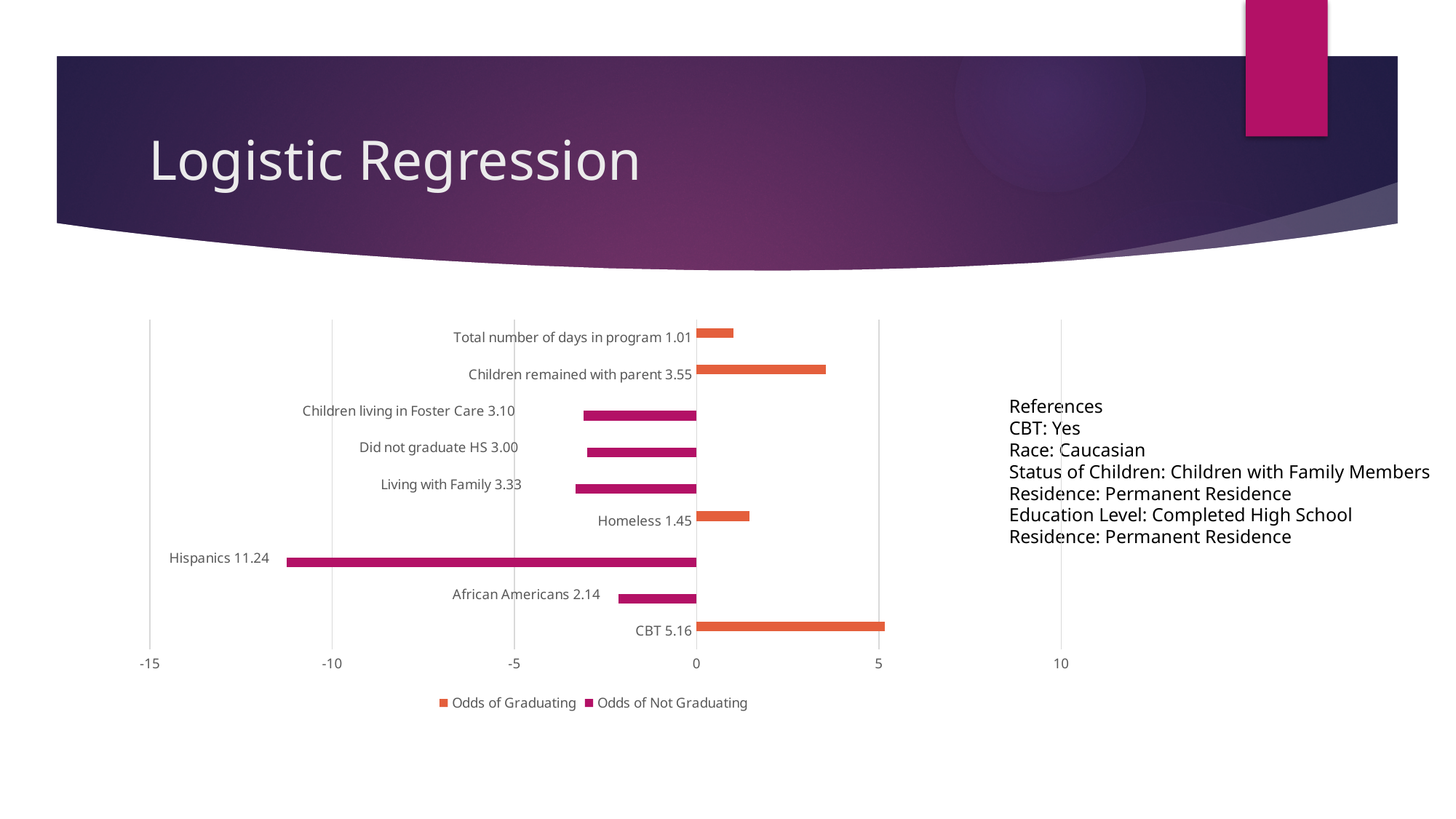
How many series does the chart legend list? 2 What value is shown for Hispanics in the chart? 11.24 Which category has the shortest bar in the chart? Total number of days in program Is the bar for Hispanics plotted greater or less than -10 on the axis? less What are the two series named in the chart legend? Odds of Graduating and Odds of Not Graduating What kind of chart is shown on the slide? Bar chart What is the difference between the value for CBT and the value for Children remained with parent? 1.61 What value is shown for Children remained with parent? 3.55 Which category has the longest bar in the chart? Hispanics What value is shown for CBT in the chart? 5.16 Which has a larger value, CBT or Homeless? CBT How many categories are plotted in the chart? 9